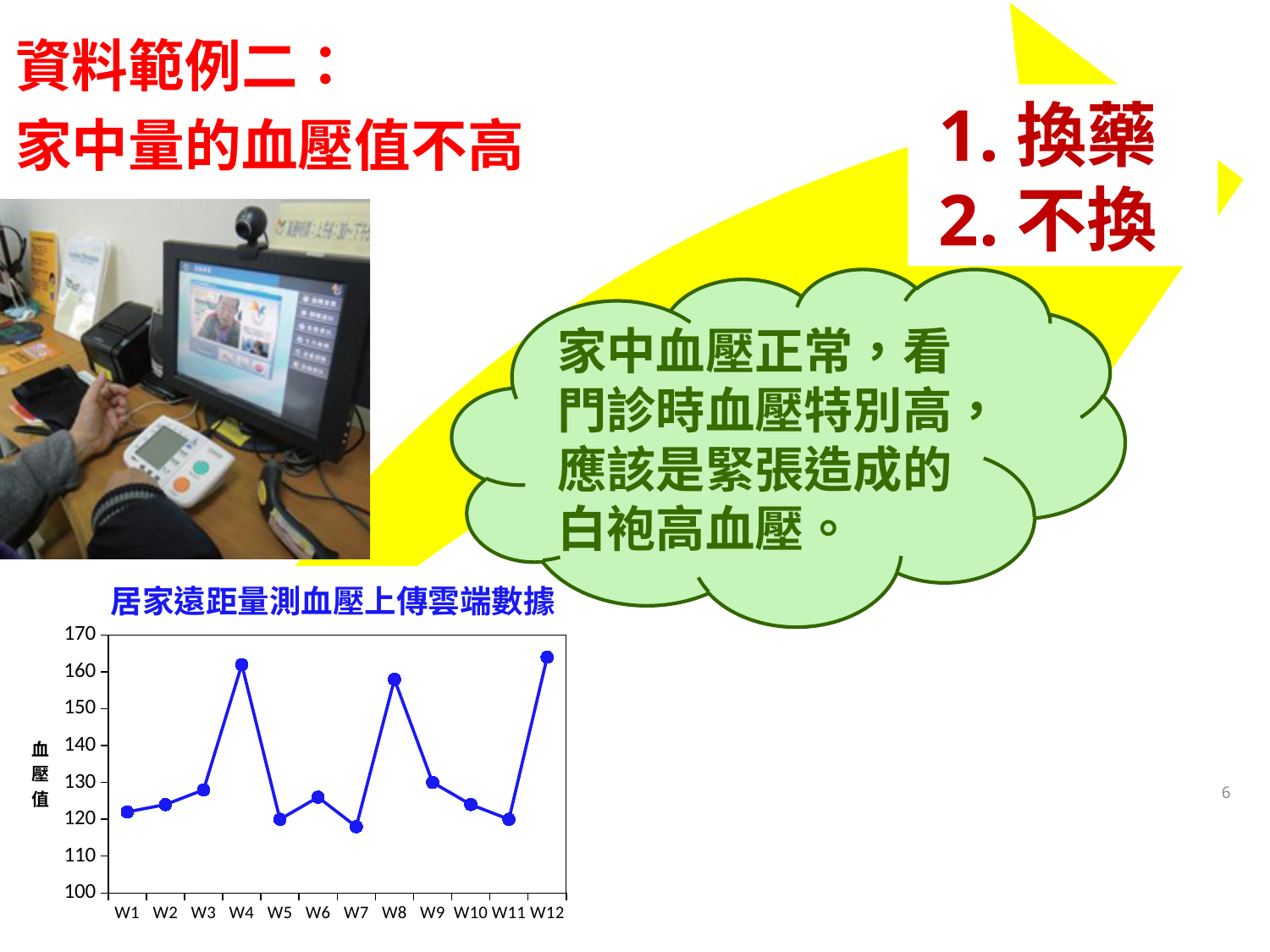
Is the value for W4 greater or less than 150? greater What is the title of the chart? 居家遠距量測血壓上傳雲端數據 Do the values rise or fall from W1 to W4? rise Which has the larger value, W4 or W5? W4 Is the value for W8 greater or less than 150? greater Is the value for W12 greater or less than 150? greater What kind of chart is shown on the slide? line chart Which has the larger value, W8 or W9? W8 What is the label on the vertical axis of the chart? 血壓值 How many weekly data points are plotted on the chart? 12